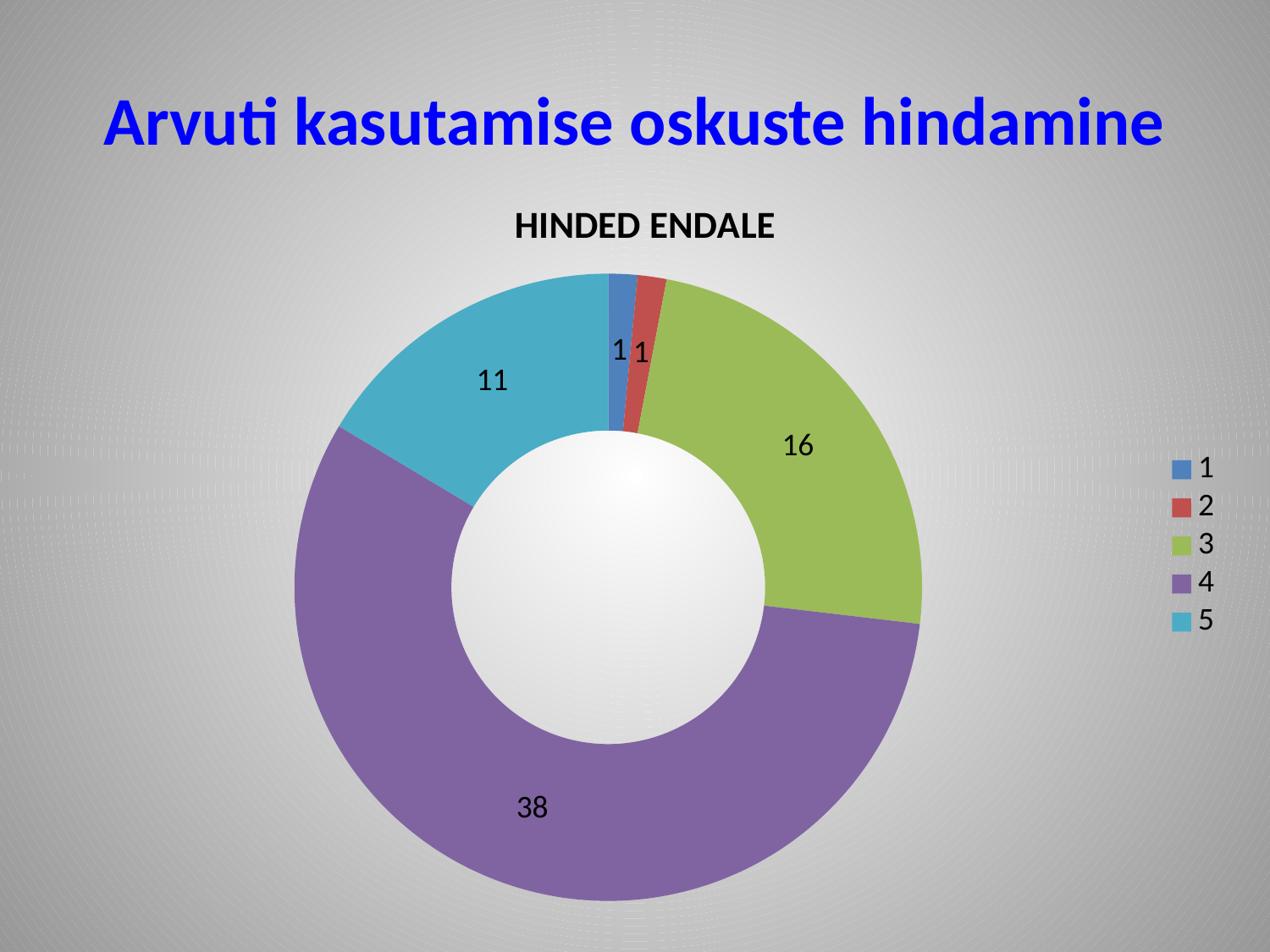
Which is larger in the HINDED ENDALE chart, the value for category 5 or the value for category 3? 3 What is the difference between the values for categories 3 and 5 in the HINDED ENDALE chart? 5 What is the title of the chart on the slide? HINDED ENDALE What is the difference between the values for categories 4 and 3 in the HINDED ENDALE chart? 22 What is the total of all the values shown in the HINDED ENDALE chart? 67 What is the value for category 4 in the HINDED ENDALE chart? 38 How many categories does the legend of the HINDED ENDALE chart list? 5 Which category has the largest value in the HINDED ENDALE chart? 4 What kind of chart is shown on the slide? doughnut chart What is the value for category 5 in the HINDED ENDALE chart? 11 What is the value for category 3 in the HINDED ENDALE chart? 16 What is the value for category 1 in the HINDED ENDALE chart? 1